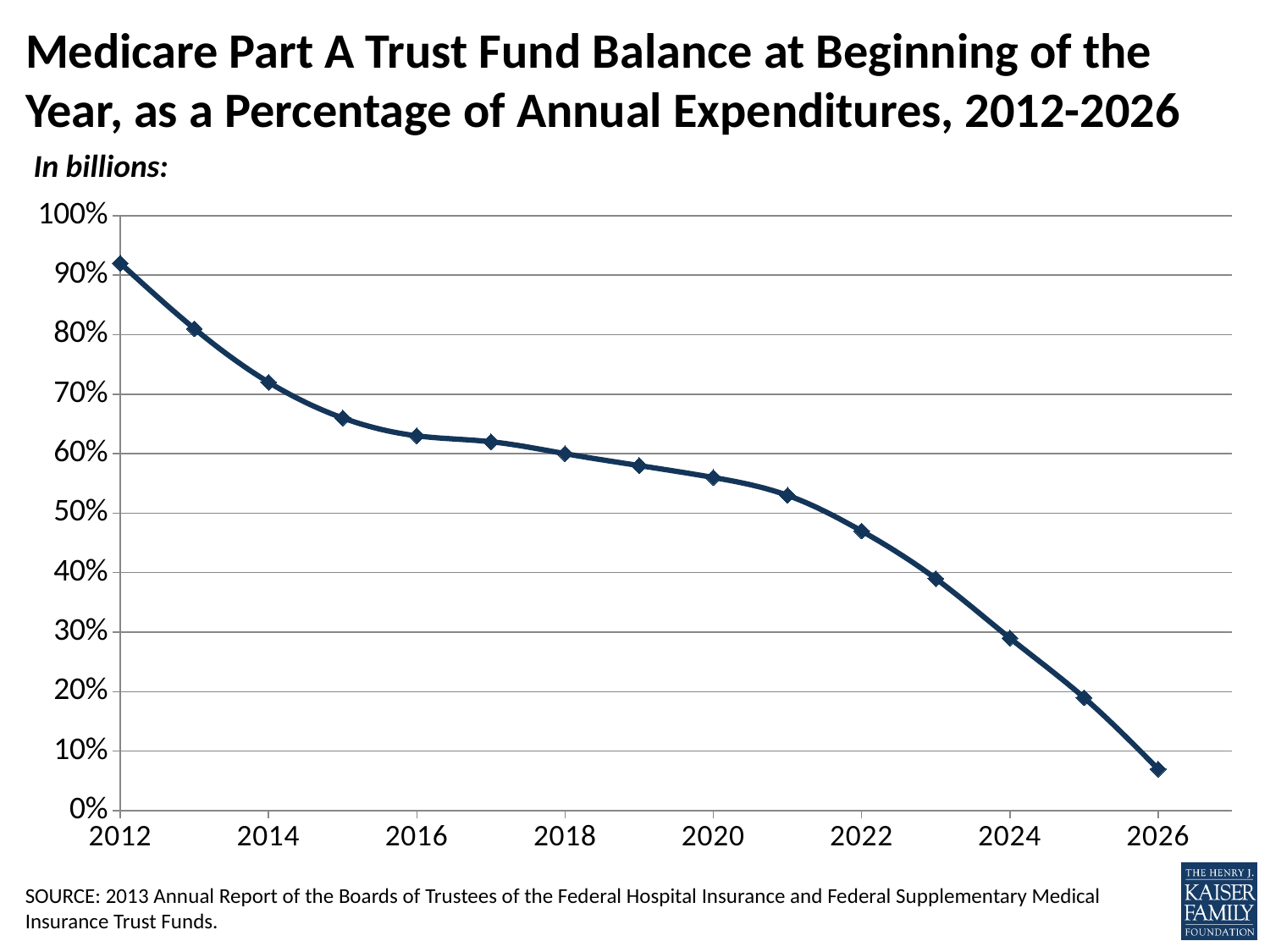
Which year has the lowest trust fund balance as a percentage of annual expenditures? 2026 Is the value for 2022 greater or less than 50%? less How many data points are plotted on the line? 15 Is the value for 2026 greater or less than 10%? less Which year has the highest trust fund balance as a percentage of annual expenditures? 2012 Do the values rise or fall from 2012 to 2026? fall What kind of chart is shown on the slide? line chart Is the value for 2014 greater or less than 70%? greater Which is larger, the value for 2016 or the value for 2024? 2016 What is the source cited for the chart? 2013 Annual Report of the Boards of Trustees of the Federal Hospital Insurance and Federal Supplementary Medical Insurance Trust Funds